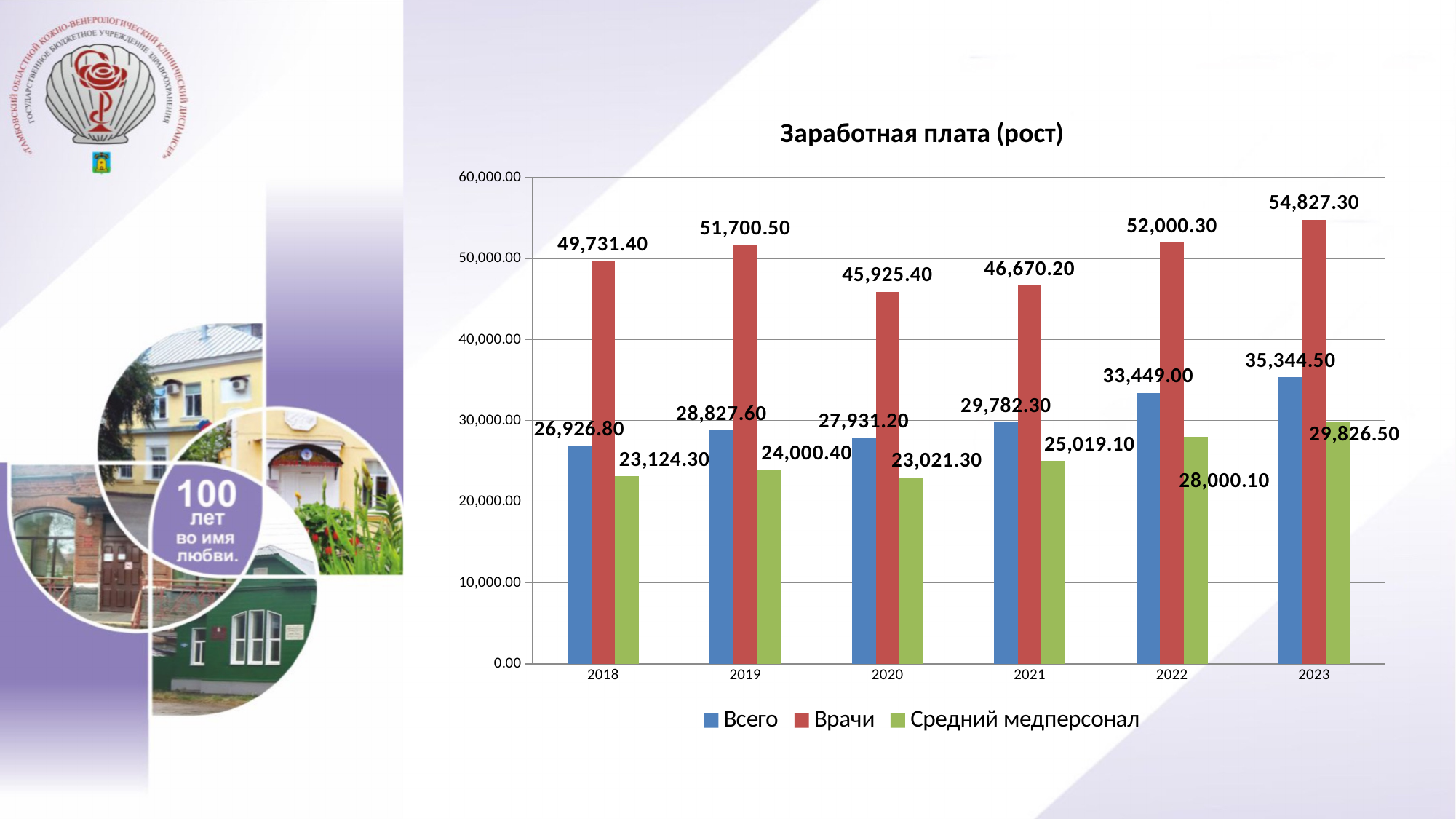
What is the difference between the Врачи values for 2023 and 2022? 2,827.00 What type of chart is shown on the slide? Bar chart Which is larger: the Средний медперсонал value in 2019 or in 2020? 2019 In which year is the value for Всего the highest? 2023 What is the title of the chart? Заработная плата (рост) What is the value for Всего in 2020? 27,931.20 What is the value for Средний медперсонал in 2021? 25,019.10 How many series does the legend list? 3 Is the value for Всего in 2022 greater or less than 30,000.00? greater In which year is the value for Врачи the lowest? 2020 How many years are shown on the x axis? 6 What is the value for Врачи in 2023? 54,827.30